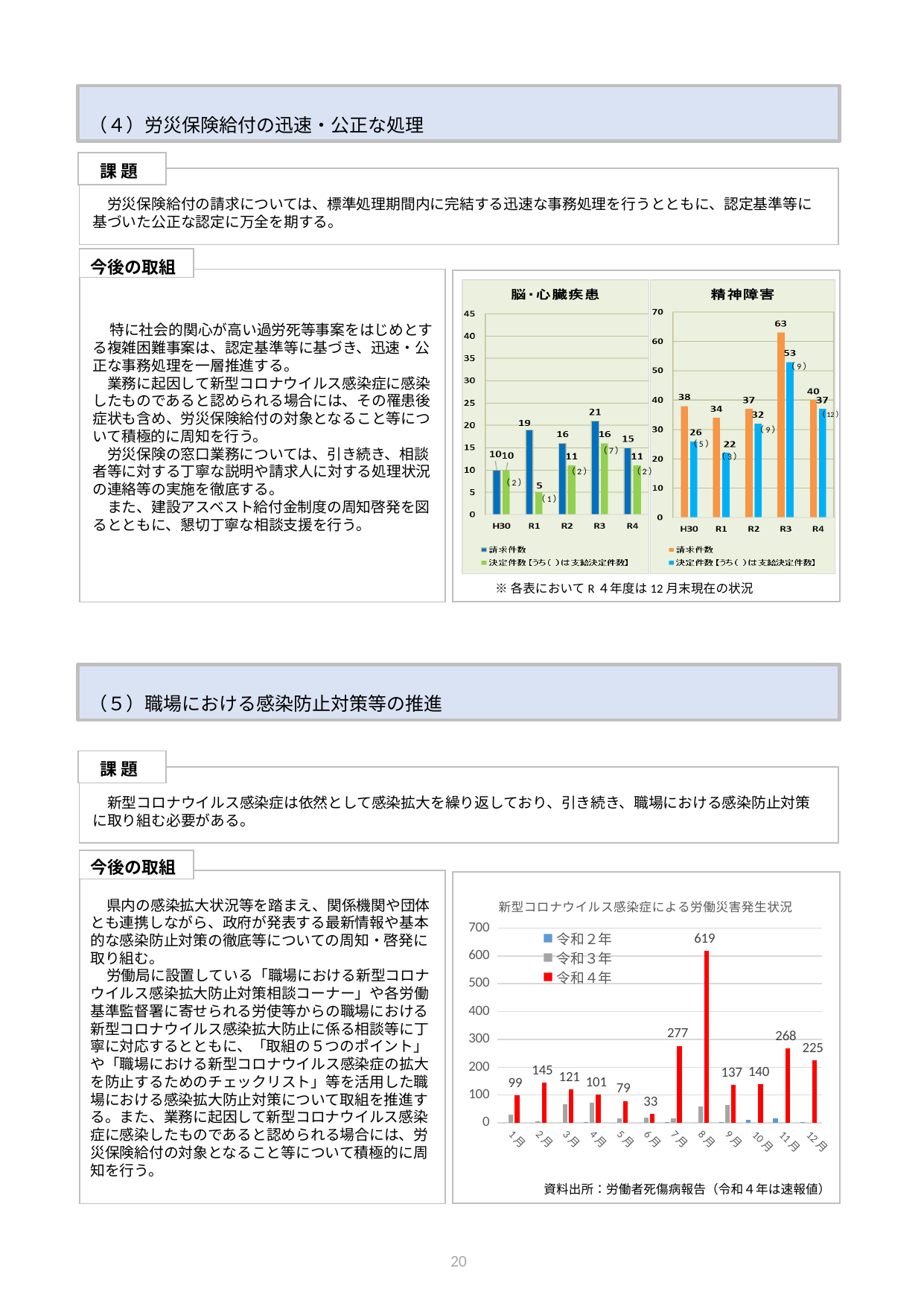
In the 新型コロナウイルス感染症による労働災害発生状況 chart, how many series does the legend list? 3 In the 新型コロナウイルス感染症による労働災害発生状況 chart, how many months are shown on the x axis? 12 In the 精神障害 chart, what is the 決定件数 value for R2? 32 In the 新型コロナウイルス感染症による労働災害発生状況 chart, which month has the lowest 令和4年 value? 6月 What kind of chart is the 新型コロナウイルス感染症による労働災害発生状況 chart? bar chart In the 精神障害 chart, what is the difference between 請求件数 and 決定件数 for R1? 12 In the 精神障害 chart, how many series does the legend list? 2 In the 新型コロナウイルス感染症による労働災害発生状況 chart, what is the 令和4年 value for 8月? 619 In the 脳・心臓疾患 chart, what is the difference between 請求件数 and 決定件数 for R4? 4 In the 精神障害 chart, which year has the highest 請求件数? R3 In the 脳・心臓疾患 chart, what is the 決定件数 value for R1? 5 In the 脳・心臓疾患 chart, what is the 請求件数 value for R3? 21